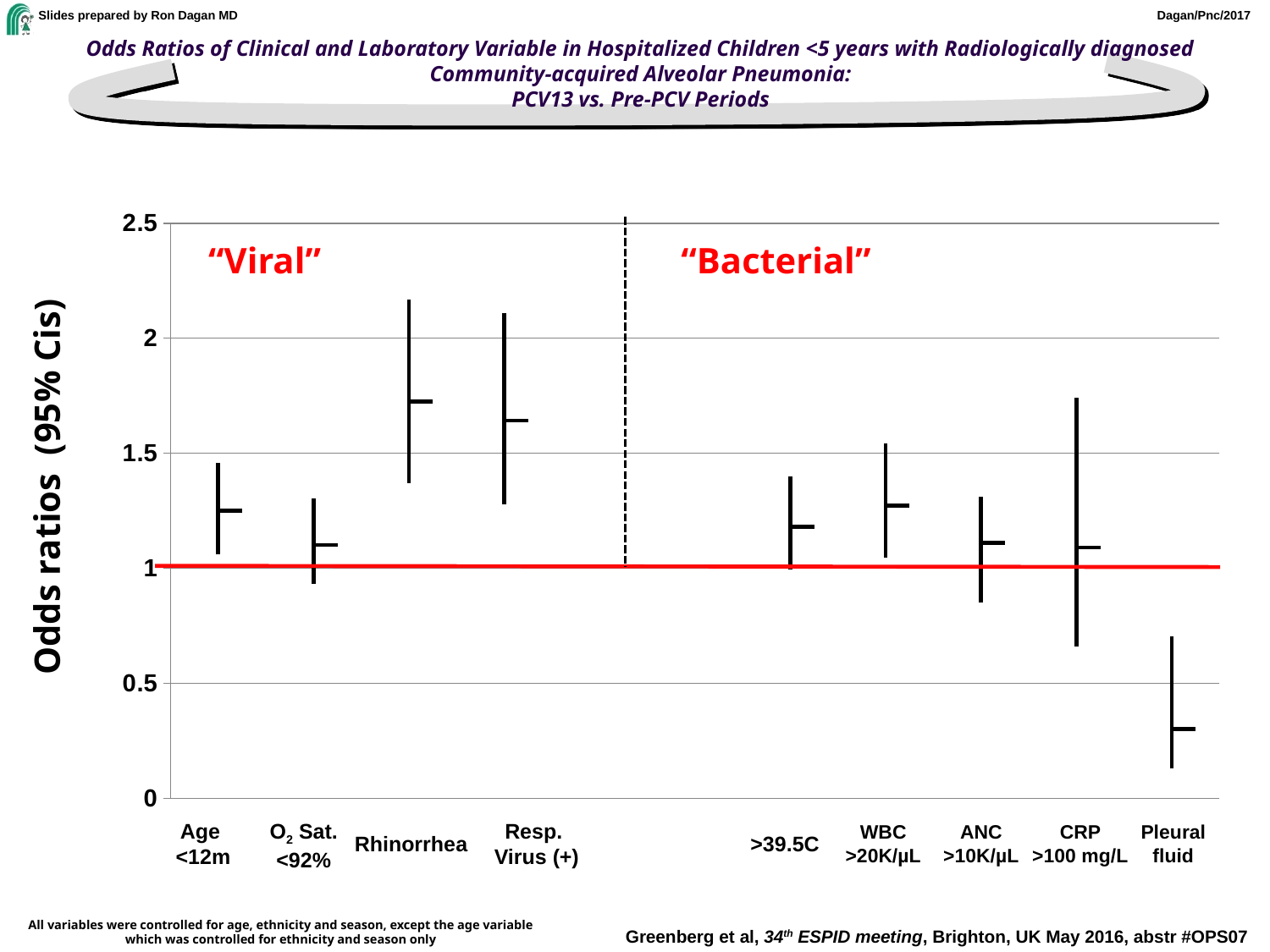
Is the odds ratio point estimate for Age <12m greater or less than 1? greater How many clinical and laboratory variables are plotted on the chart? 9 Is the odds ratio point estimate for Pleural fluid greater or less than 0.5? less Is the odds ratio point estimate for Resp. Virus (+) greater or less than 1.5? greater At what odds ratio value is the red horizontal reference line drawn? 1 Which has the larger odds ratio point estimate, Age <12m or O2 Sat. <92%? Age <12m What kind of chart is shown on the slide? Error bar chart of point estimates with 95% confidence intervals What are the two group labels written above the plotted variables? "Viral" and "Bacterial" Which variable has the lowest odds ratio point estimate? Pleural fluid Which variable has the highest odds ratio point estimate? Rhinorrhea Which has the larger odds ratio point estimate, Rhinorrhea or Pleural fluid? Rhinorrhea